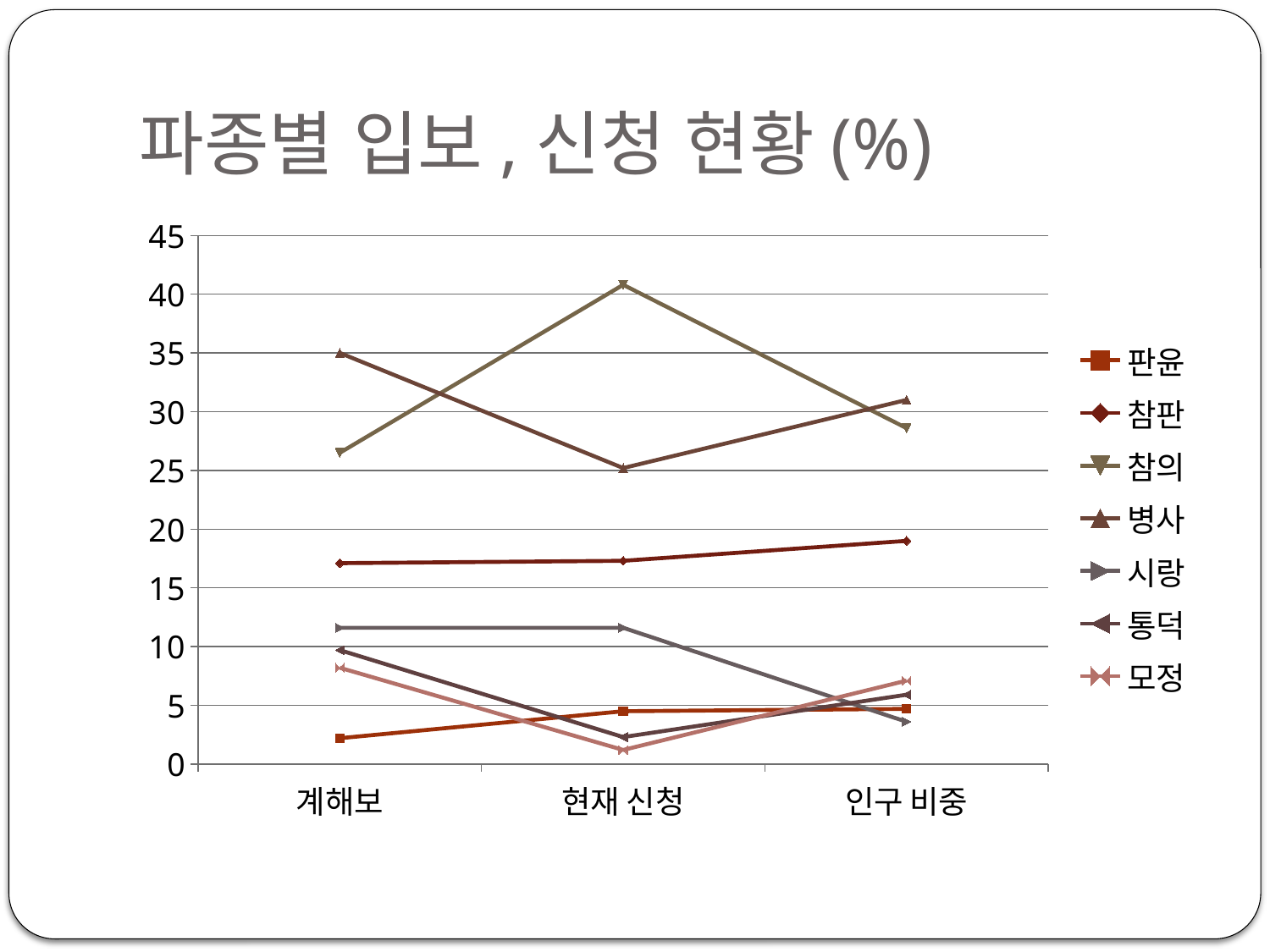
Is the value for 참의 at 현재 신청 greater or less than 35? greater Is the value for 판윤 at 계해보 greater or less than 5? less What is the title of the chart? 파종별 입보 , 신청 현황 (%) Is the value for 병사 at 계해보 greater or less than 30? greater How many categories are shown on the x axis? 3 Which series has the highest value at 현재 신청? 참의 What kind of chart is shown on the slide? line chart At 인구 비중, which is larger: 병사 or 참의? 병사 Which series has the highest value at 계해보? 병사 How many series does the legend list? 7 Which series has the lowest value at 계해보? 판윤 Does the 참판 series rise or fall from 계해보 to 인구 비중? rise